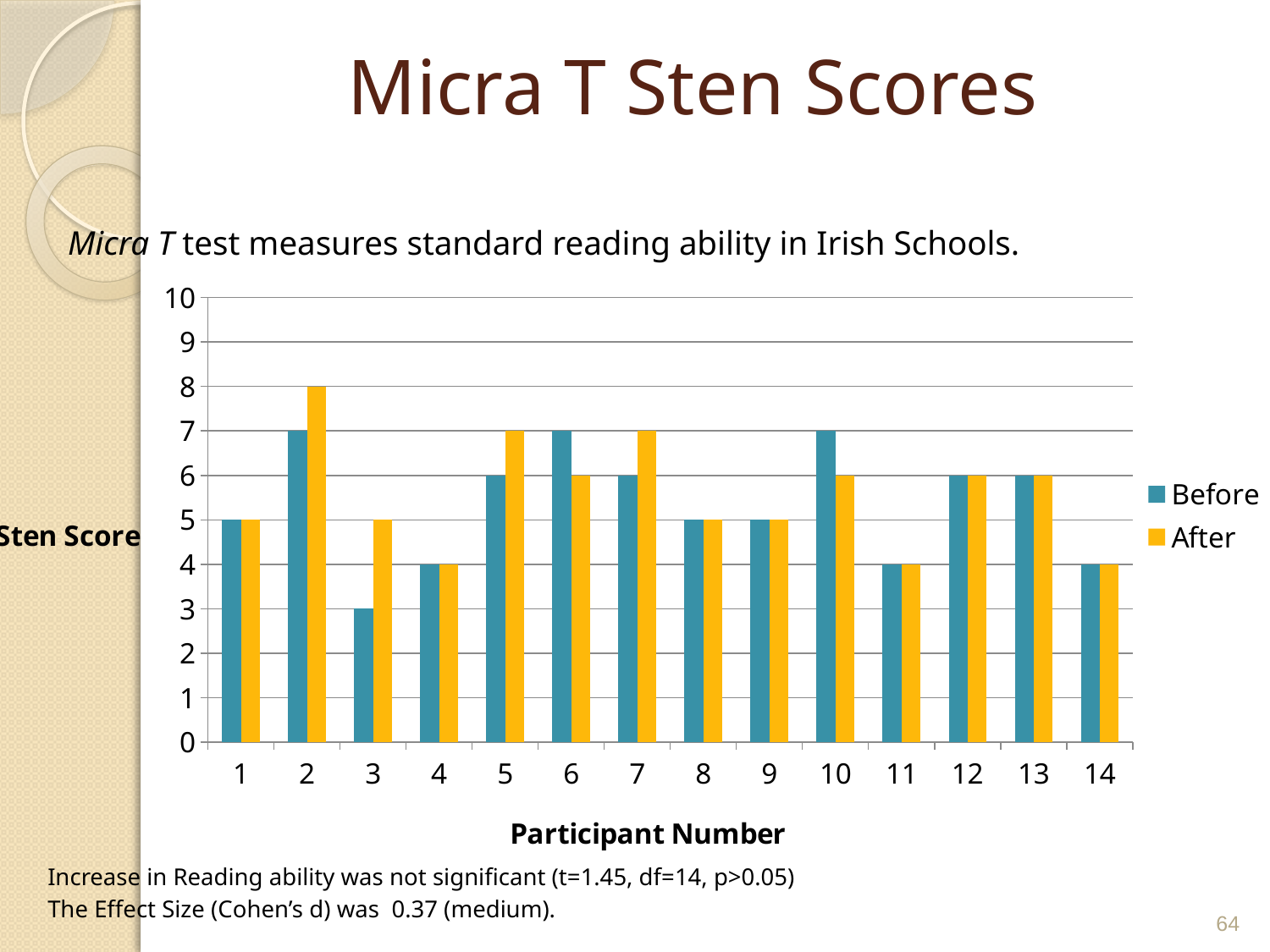
What is the difference between the After and Before Sten scores for participant 3? 2 Is the Before Sten score for participant 6 greater or less than 5? greater Which participant has the lowest Before Sten score? 3 What kind of chart is shown on the slide? bar chart What is the label of the x axis? Participant Number How many participants are shown on the x axis? 14 What is the After Sten score for participant 5? 7 Which participant has the highest After Sten score? 2 What is the Before Sten score for participant 3? 3 What is the After Sten score for participant 2? 8 How many series does the legend list? 2 For participant 10, which is larger, the Before or the After Sten score? Before